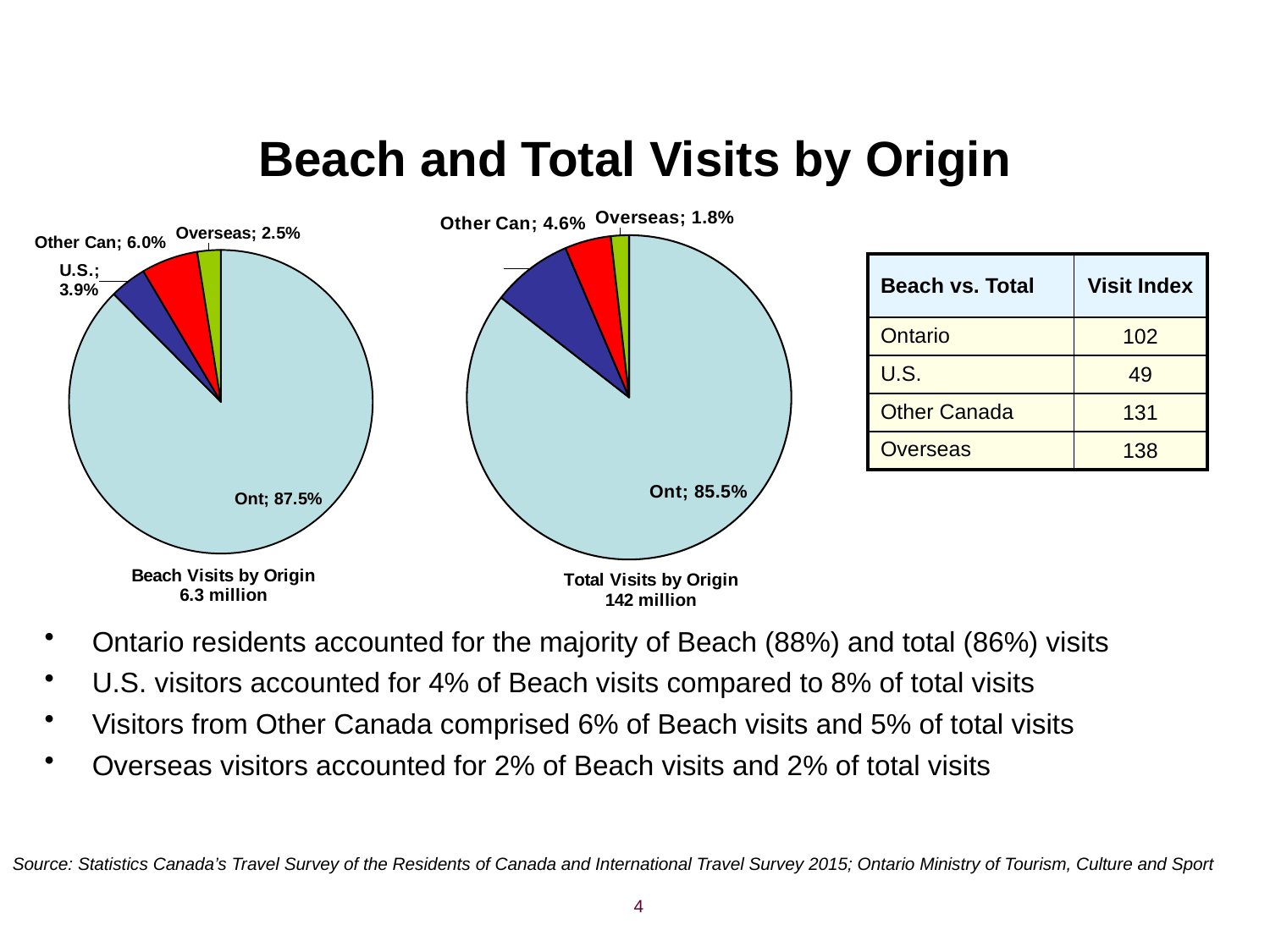
In the Beach Visits by Origin pie chart, which origin has the largest slice? Ont In the Beach Visits by Origin pie chart, which slice is larger: Other Can or U.S.? Other Can In the Beach Visits by Origin pie chart, what share of visits is labelled for Overseas? 2.5% In the Beach Visits by Origin pie chart, which origin has the smallest slice? Overseas In the Beach Visits by Origin pie chart, what share of visits is labelled for Other Can? 6.0% In the Total Visits by Origin pie chart, what share of visits is labelled for Ont? 85.5% In the Total Visits by Origin pie chart, what share of visits is labelled for Other Can? 4.6% What kind of chart is used for Beach Visits by Origin? Pie chart In the Total Visits by Origin pie chart, what share of visits is labelled for Overseas? 1.8% In the Beach Visits by Origin pie chart, what share of visits is labelled for Ont? 87.5% What is the difference between the Ont share in the Beach Visits by Origin pie chart and the Ont share in the Total Visits by Origin pie chart? 2.0% In the Beach Visits by Origin pie chart, what share of visits is labelled for U.S.? 3.9%